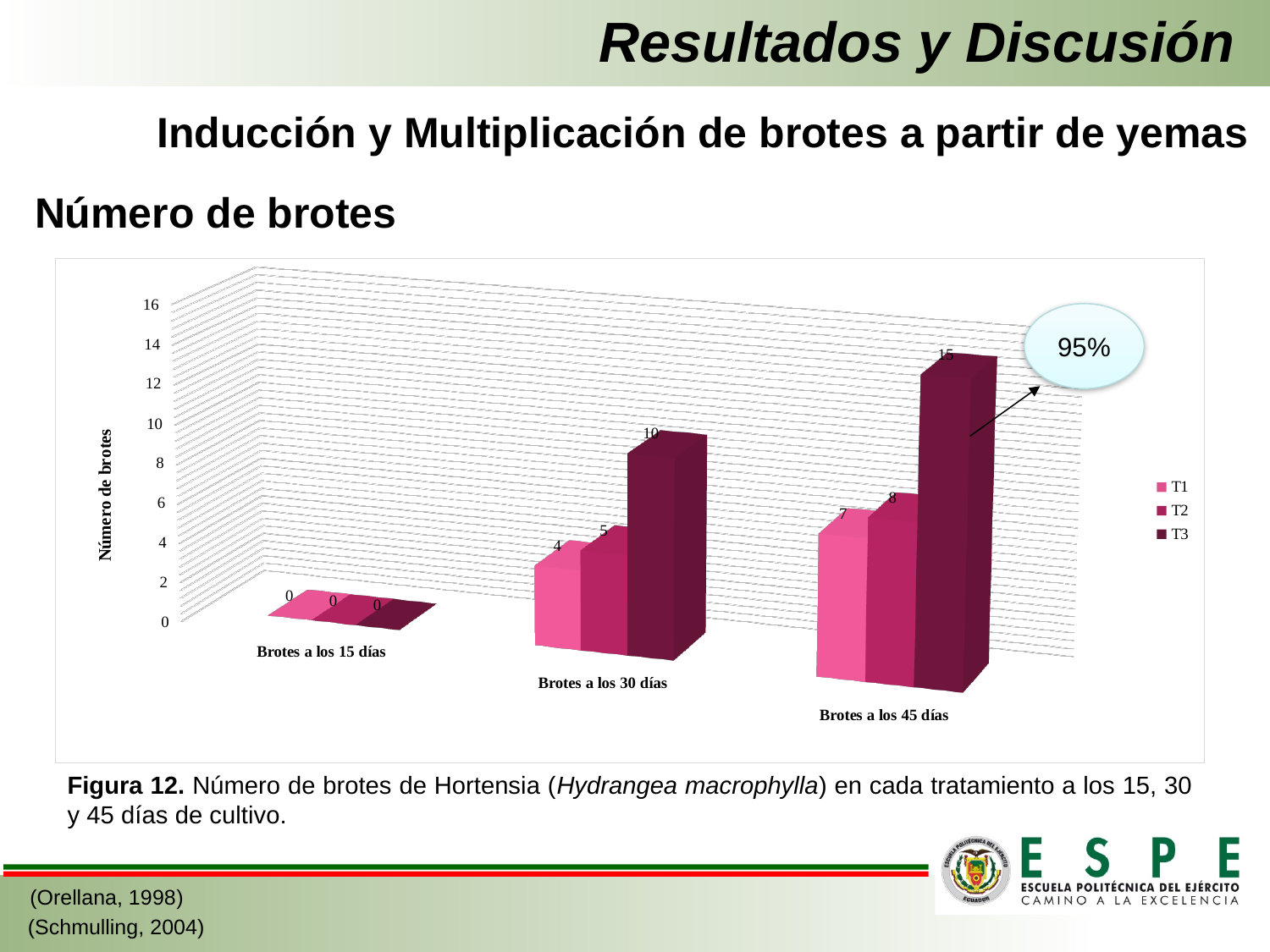
What kind of chart is shown? bar chart What is the difference between T3 and T2 at 'Brotes a los 30 días'? 5 Which is larger, T2 at 'Brotes a los 30 días' or T1 at 'Brotes a los 45 días'? T1 at 'Brotes a los 45 días' Which treatment has the highest value at 'Brotes a los 45 días'? T3 What is the value for T3 at 'Brotes a los 30 días'? 10 What is the value for T3 at 'Brotes a los 45 días'? 15 How many series does the legend list? 3 What is the difference between T3 and T1 at 'Brotes a los 45 días'? 8 How many categories are shown on the x axis? 3 What is the value for T1 at 'Brotes a los 30 días'? 4 Do the values for T3 rise or fall from 'Brotes a los 15 días' to 'Brotes a los 45 días'? rise What is the value for T2 at 'Brotes a los 45 días'? 8